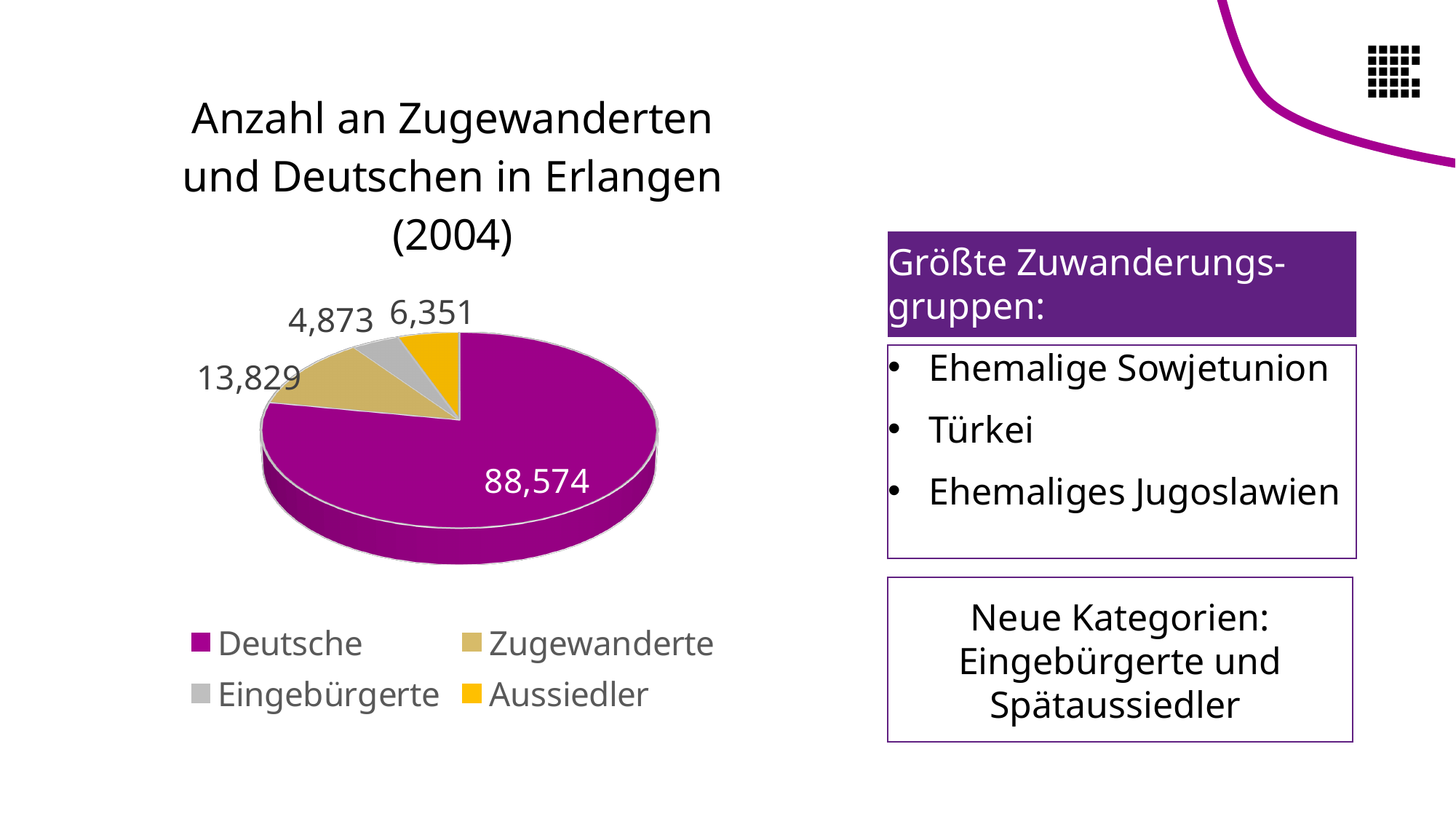
What is the value for Deutsche in the pie chart? 88,574 Which category has the smallest slice in the pie chart? Eingebürgerte What is the difference between the values for Aussiedler and Eingebürgerte? 1,478 What is the title of the pie chart? Anzahl an Zugewanderten und Deutschen in Erlangen (2004) Which category has the largest slice in the pie chart? Deutsche How many categories does the pie chart show? 4 What is the value for Eingebürgerte in the pie chart? 4,873 Which is larger, the value for Zugewanderte or the value for Aussiedler? Zugewanderte What is the value for Zugewanderte in the pie chart? 13,829 What is the value for Aussiedler in the pie chart? 6,351 What is the difference between the values for Deutsche and Zugewanderte? 74,745 What kind of chart is shown on the slide? Pie chart